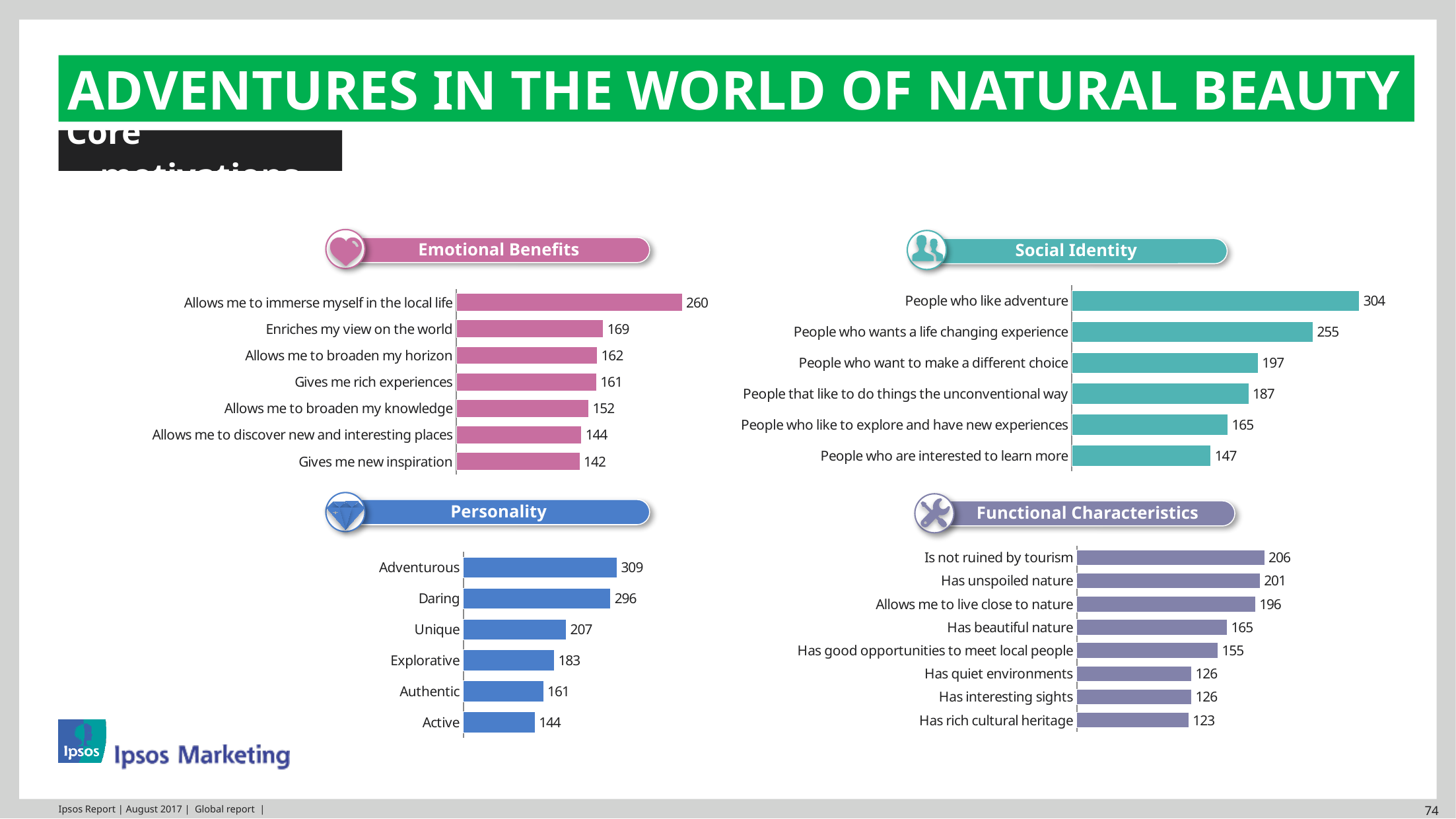
In the Emotional Benefits chart, what is the value for "Allows me to immerse myself in the local life"? 260 How many categories are shown in the Functional Characteristics chart? 8 How many charts are shown on the slide? 4 In the Functional Characteristics chart, which category has the lowest value? Has rich cultural heritage In the Personality chart, what is the difference between the values for "Adventurous" and "Daring"? 13 In the Social Identity chart, which category has the highest value? People who like adventure In the Functional Characteristics chart, what is the value for "Has unspoiled nature"? 201 What type of chart is the Personality chart? Bar chart In the Social Identity chart, what is the difference between the values for "People who like adventure" and "People who are interested to learn more"? 157 How many categories are shown in the Emotional Benefits chart? 7 In the Personality chart, what is the value for "Explorative"? 183 In the Social Identity chart, which is larger: the value for "People who want to make a different choice" or "People that like to do things the unconventional way"? People who want to make a different choice